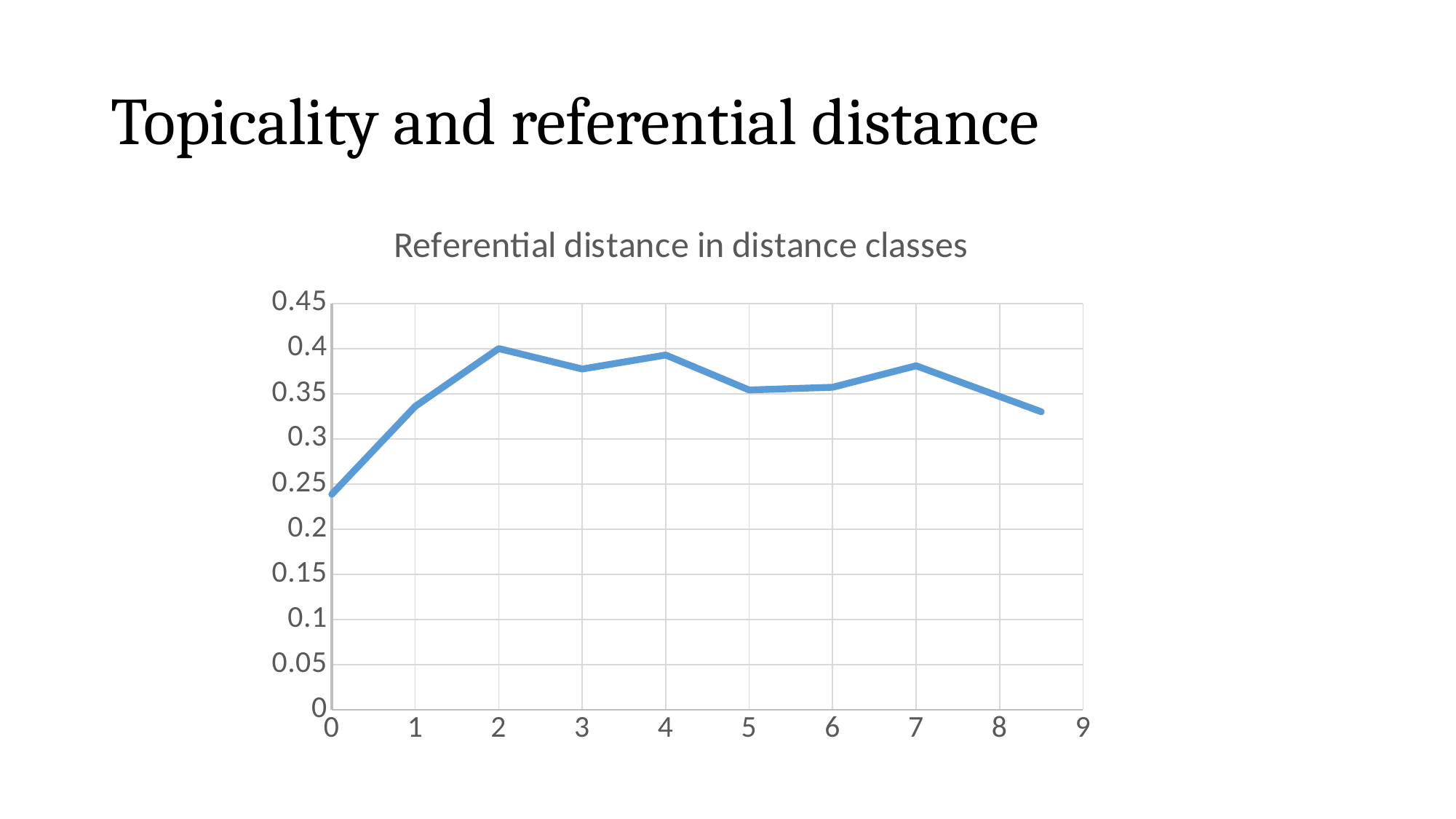
What is the title of the chart? Referential distance in distance classes Is the value at x = 3 greater or less than 0.35? greater Is the value at x = 0 greater or less than 0.25? less Is the value at x = 1 greater or less than 0.35? less At which x value is the plotted value lowest? 0 Does the line rise or fall between x = 0 and x = 2? rise Which is larger, the value at x = 0 or the value at x = 1? x = 1 What kind of chart is shown on the slide? line chart How many data points are plotted on the line? 9 Which is larger, the value at x = 7 or the value at x = 5? x = 7